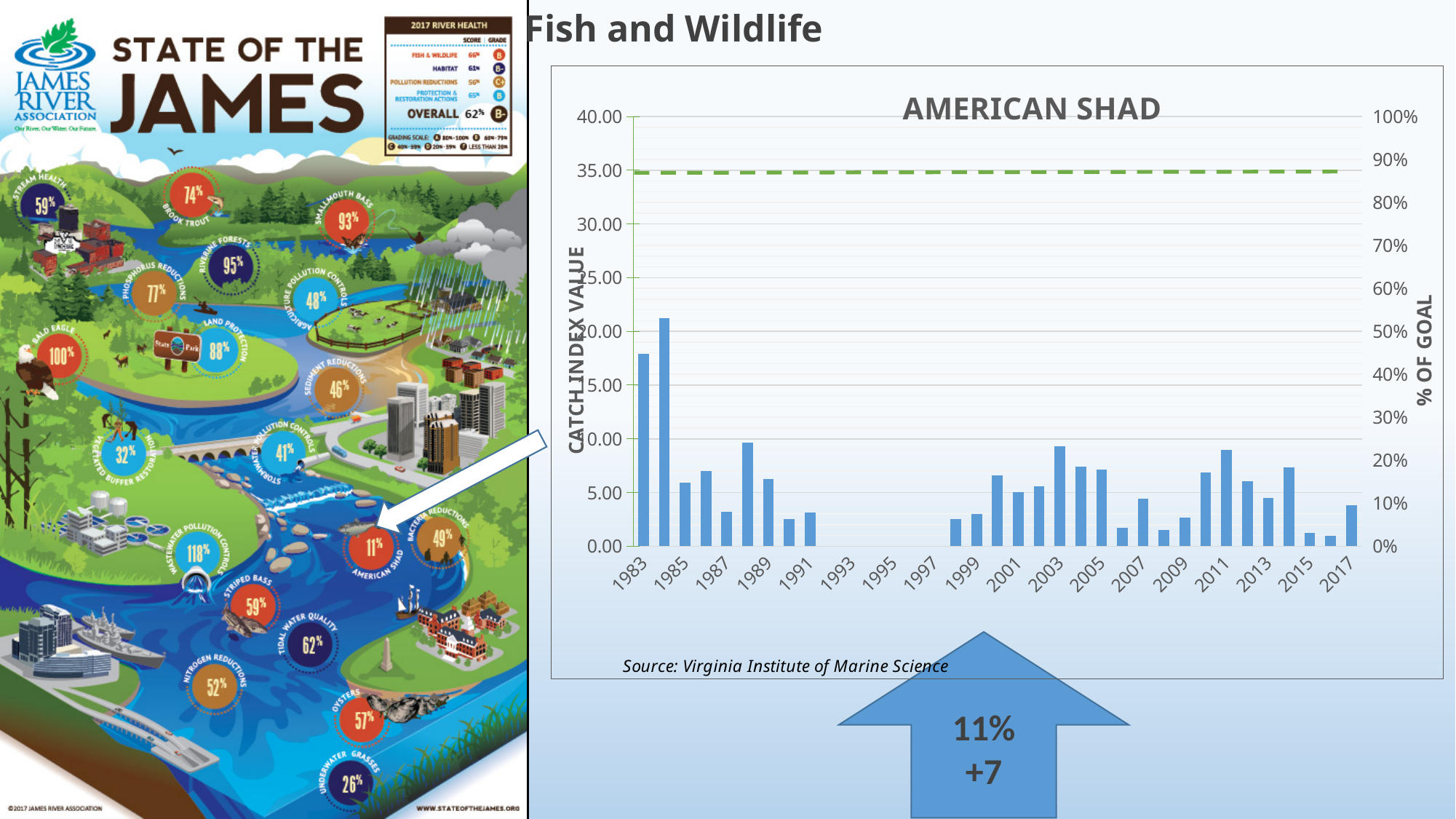
What kind of chart is used to show the American Shad catch index values? bar chart What is the title of the chart? AMERICAN SHAD What is the label of the left vertical axis of the American Shad chart? CATCH INDEX VALUE Which year has the highest catch index value in the American Shad chart? 1984 Which year has the larger catch index value, 2003 or 2007? 2003 Do the catch index values rise or fall from 1984 to 1991? fall Which year has the larger catch index value, 1983 or 1984? 1984 Is the catch index value for 1984 greater or less than 20.00? greater Is the catch index value for 1983 greater or less than 20.00? less Is the catch index value for 1990 greater or less than 5.00? less